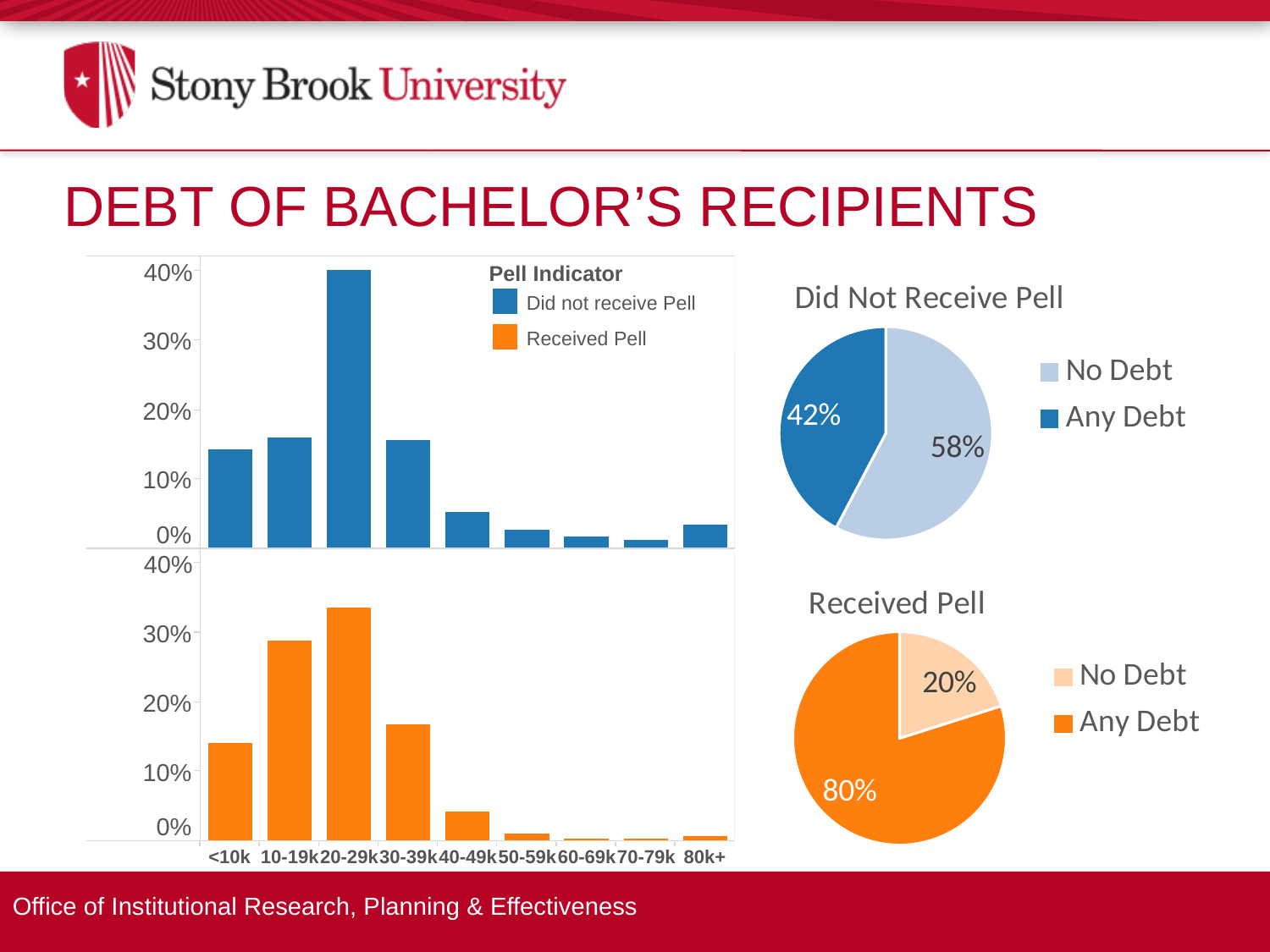
In the bar chart on the left, how many debt categories are shown on the x axis? 9 In the 'Did Not Receive Pell' pie chart, what share is labelled for No Debt? 58% In the 'Did Not Receive Pell' pie chart, what share is labelled for Any Debt? 42% In the 'Received Pell' pie chart, what share is labelled for Any Debt? 80% In the bar chart on the left, how many entries does the Pell Indicator legend list? 2 In the bar chart on the left, is the value for 10-19k among students who received Pell greater or less than 20%? greater In the bar chart on the left, which debt category has the highest bar for students who did not receive Pell? 20-29k In the bar chart on the left, which debt category has the highest bar for students who received Pell? 20-29k In the 'Received Pell' pie chart, what is the difference between the Any Debt and No Debt shares? 60% In the 'Did Not Receive Pell' pie chart, which slice is larger, No Debt or Any Debt? No Debt In the bar chart on the left, is the value for 40-49k among students who did not receive Pell greater or less than 10%? less In the 'Received Pell' pie chart, what share is labelled for No Debt? 20%